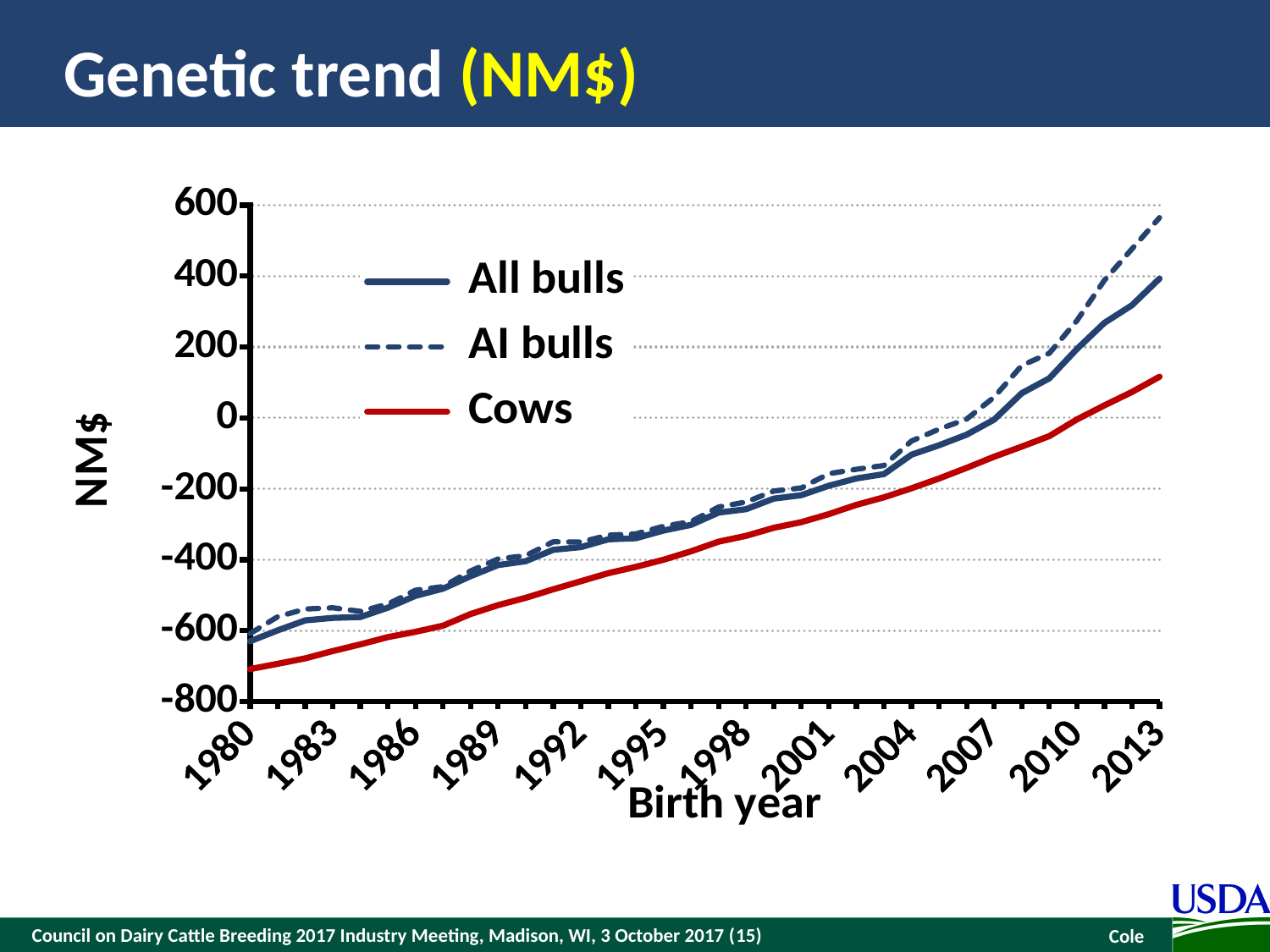
Do the NM$ values for Cows rise or fall from 1980 to 2013? rise What kind of chart is shown on the slide? line chart Which series has the lowest NM$ value at birth year 1980? Cows Is the NM$ value for Cows in 2013 greater or less than 0? greater At birth year 2013, which is larger: the NM$ value for AI bulls or for Cows? AI bulls Is the NM$ value for Cows in 1980 greater or less than -600? less What is the label of the x axis? Birth year Which series is drawn with a dashed line? AI bulls Is the NM$ value for AI bulls in 2013 greater or less than 400? greater How many series does the legend list? 3 Which series has the highest NM$ value at birth year 2013? AI bulls